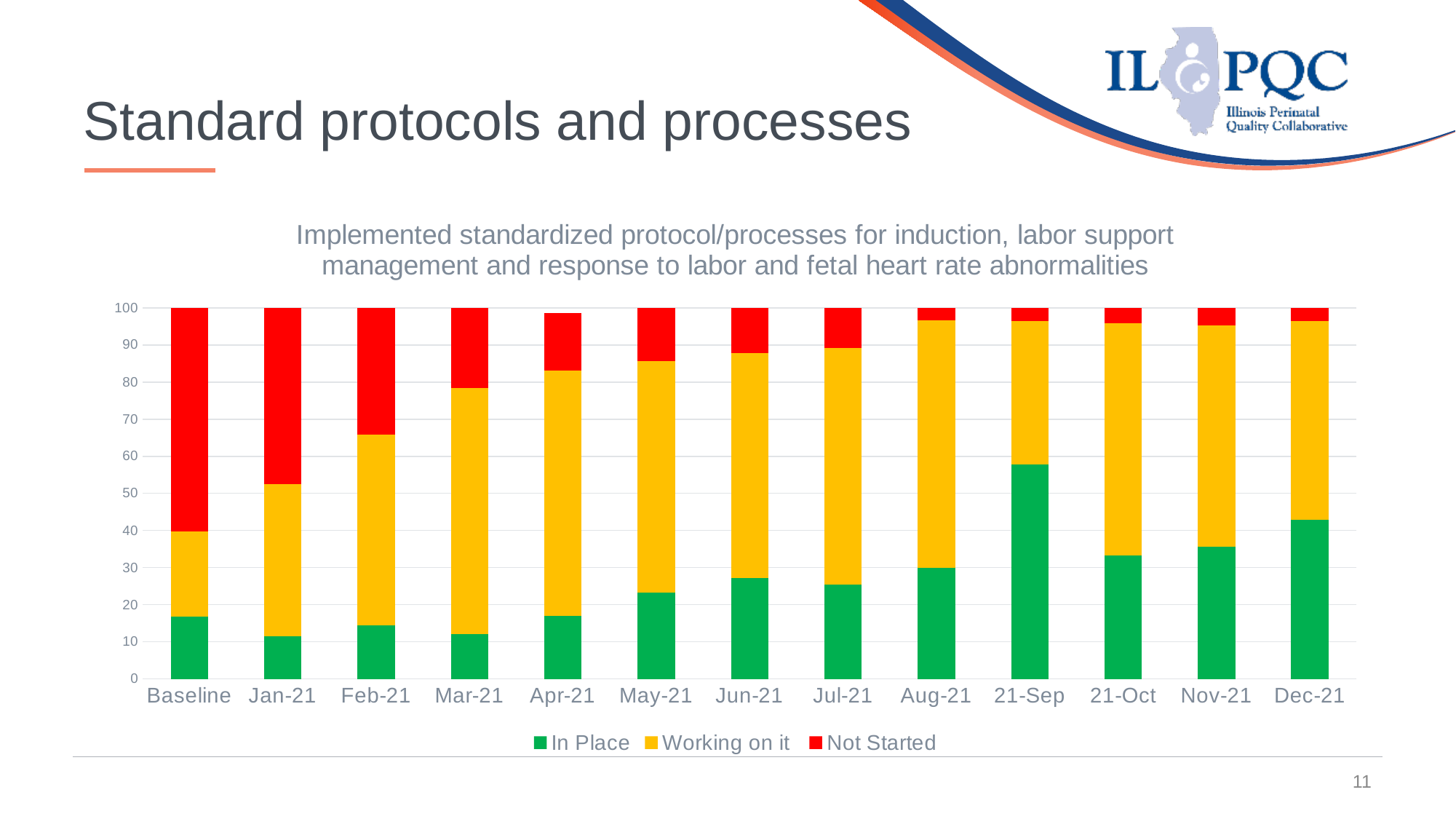
Does the 'Not Started' segment generally rise or fall from Baseline to Dec-21? fall Is the 'In Place' value for 21-Sep greater or less than 50? greater Is the 'In Place' value for Dec-21 greater or less than 40? greater Which category has the highest 'In Place' value? 21-Sep Which colour represents the 'Working on it' series? Yellow Is the 'In Place' value for Jan-21 greater or less than 20? less How many categories are shown along the x axis? 13 Which category has the largest 'Not Started' segment? Baseline Which is larger, the 'In Place' value for Dec-21 or for Nov-21? Dec-21 How many series does the legend list? 3 What kind of chart is shown on the slide? Stacked bar chart Which is larger, the 'Not Started' segment for Feb-21 or for Mar-21? Feb-21